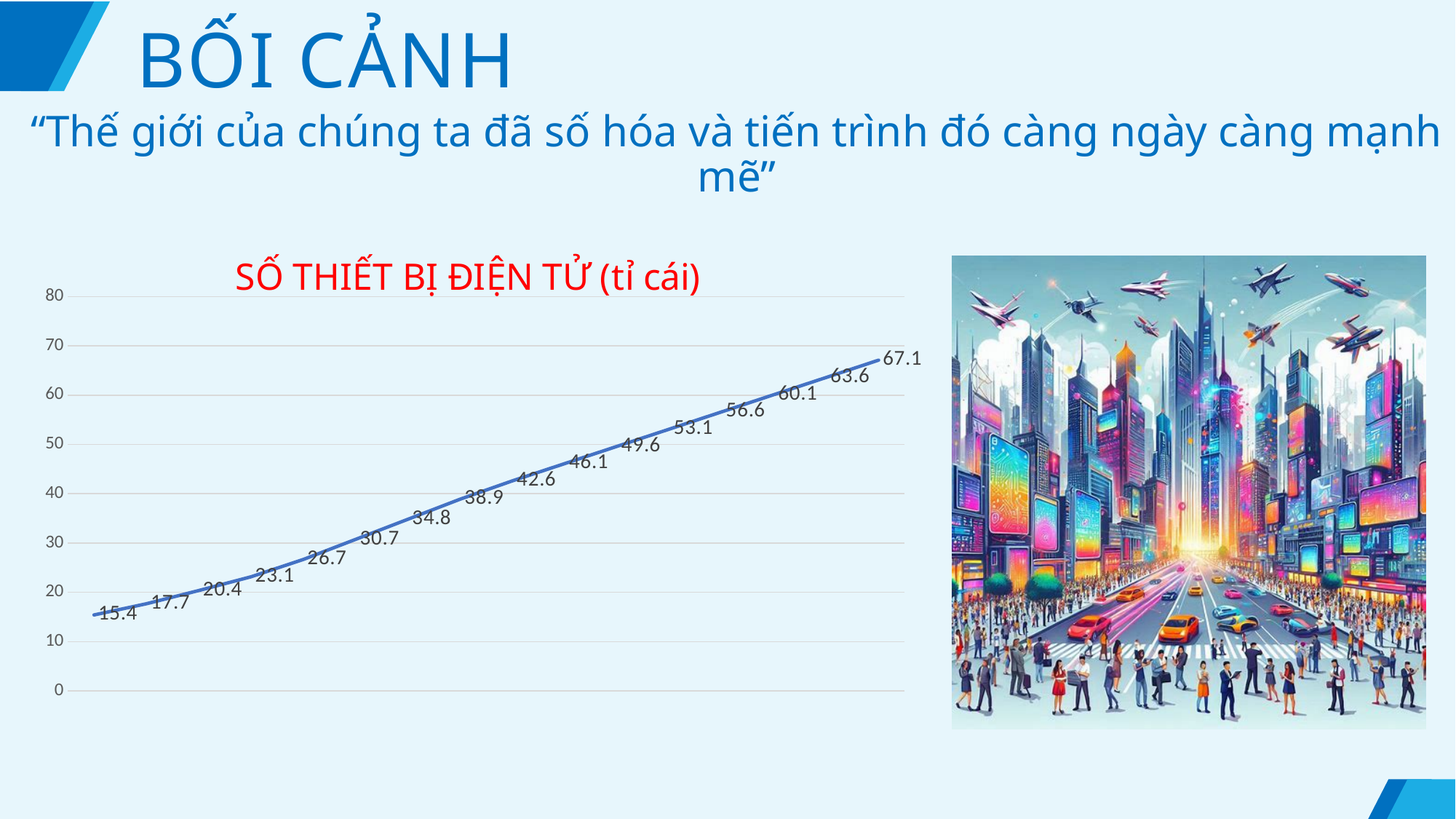
Which is larger, the value 42.6 or the value 38.9 on the line? 42.6 What is the highest value shown on the chart? 67.1 Is the last point on the line (67.1) greater or less than 70? less What is the lowest value shown on the chart? 15.4 What kind of chart is shown on the slide? line chart What is the value of the first (leftmost) point on the line? 15.4 What is the maximum value shown on the vertical axis? 80 How many data points are plotted on the line? 16 What is the difference between the last value (67.1) and the first value (15.4)? 51.7 What is the value of the last (rightmost) point on the line? 67.1 What is the title of the chart? SỐ THIẾT BỊ ĐIỆN TỬ (tỉ cái) Do the values rise or fall from left to right along the x axis? rise